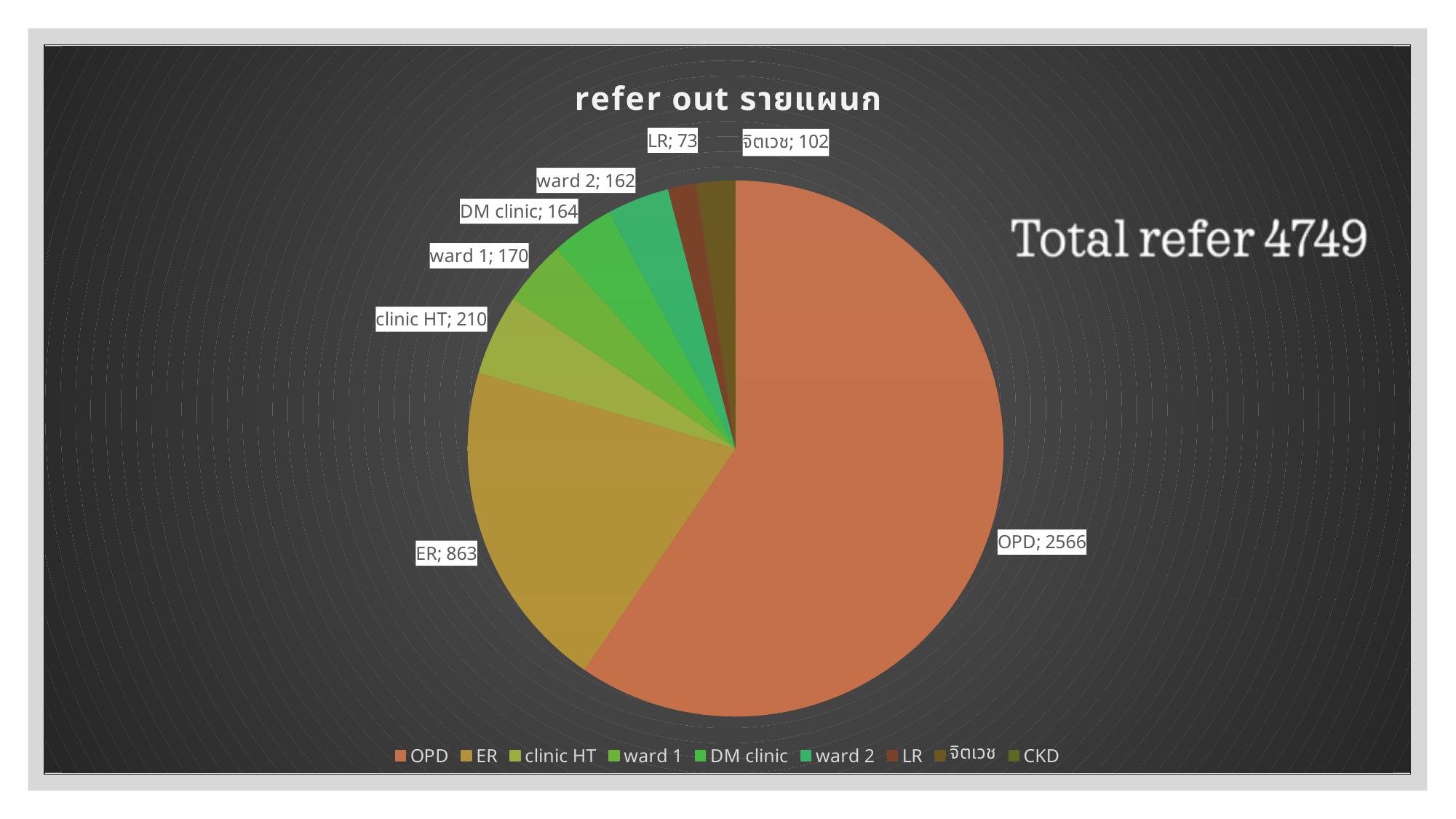
What is the value for ER? 863 What is the value for LR? 73 Which labelled category has the smallest value? LR Which is larger, the value for ward 1 or the value for ward 2? ward 1 What type of chart is shown on the slide? pie chart What is the value for clinic HT? 210 What is the difference between the values for OPD and ER? 1703 How many entries does the legend list? 9 What is the title of the chart? refer out รายแผนก What is the value for จิตเวช? 102 Which category has the largest slice? OPD What is the value for OPD? 2566